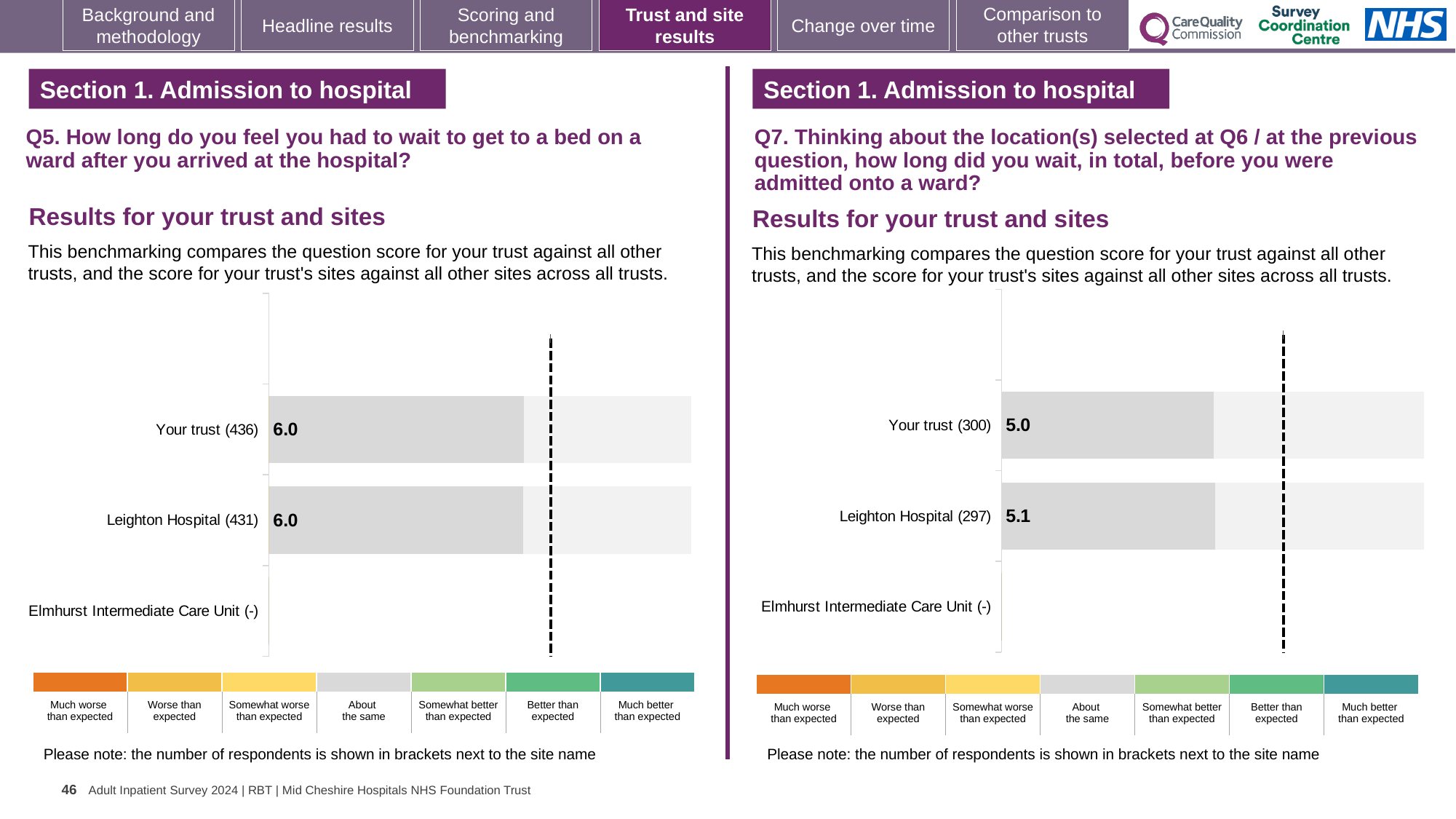
In the Q7 chart on the right, which has the higher score, Your trust or Leighton Hospital? Leighton Hospital In the Q5 chart on the left, what is the score for Leighton Hospital (431)? 6.0 In the Q7 chart on the right, which category has no bar plotted? Elmhurst Intermediate Care Unit (-) How many site/trust categories are listed on the vertical axis of the Q5 chart on the left? 3 In the Q5 chart on the left, how many respondents are shown in brackets for Leighton Hospital? 431 In the Q7 chart on the right, what is the score for Leighton Hospital (297)? 5.1 In the Q7 chart on the right, what is the score for Your trust (300)? 5.0 In the Q5 chart on the left, what is the score for Your trust (436)? 6.0 In the Q5 chart on the left, what is the difference between the Your trust score and the Leighton Hospital score? 0.0 In the Q7 chart on the right, how many respondents are shown in brackets for Your trust? 300 In the Q7 chart on the right, what is the difference between the Leighton Hospital score and the Your trust score? 0.1 What kind of chart is used for the Q7 results on the right? Bar chart